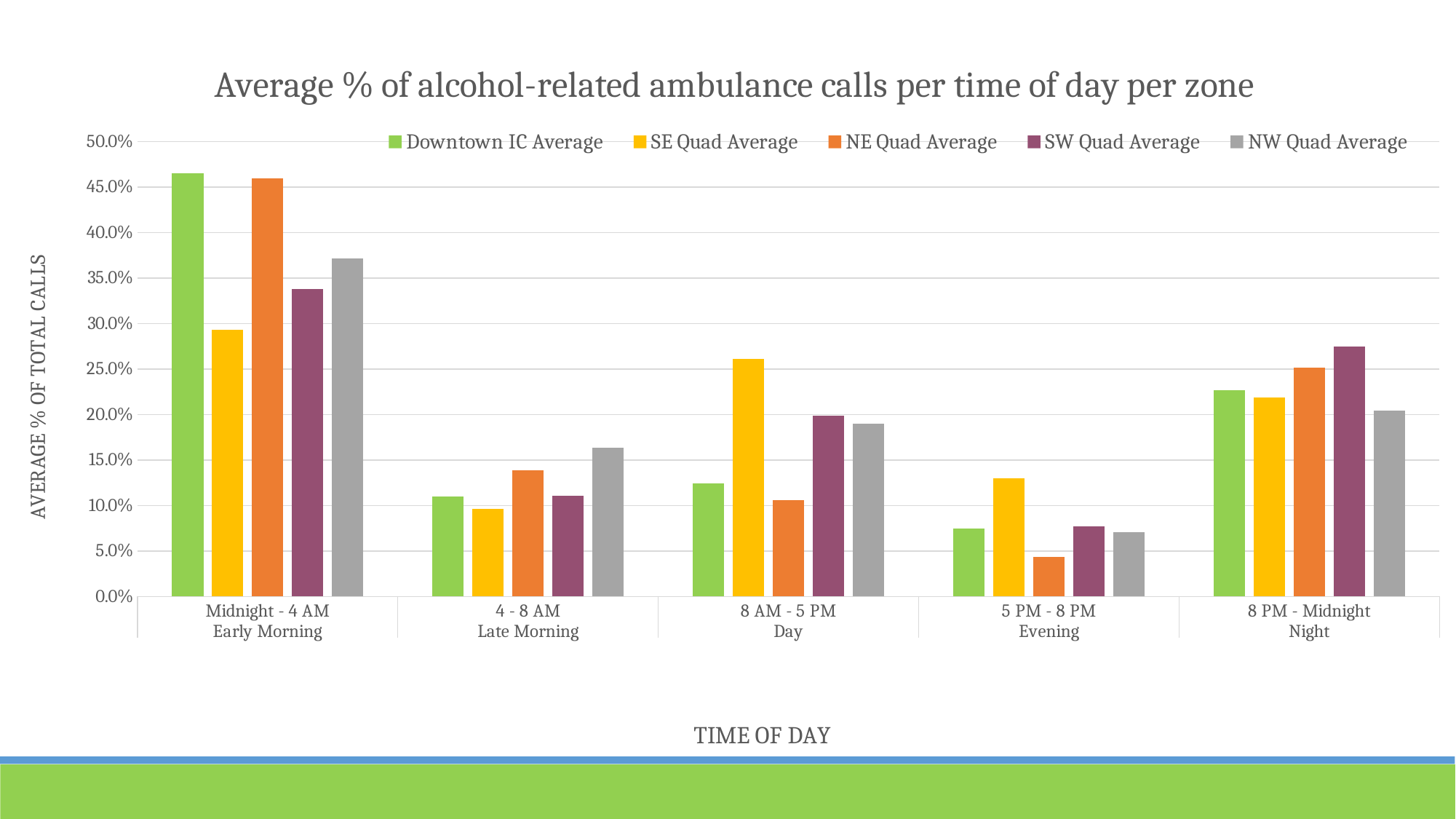
How many time-of-day categories are shown on the x axis? 5 Which series has the highest value for 8 AM - 5 PM Day? SE Quad Average Is the NE Quad Average value for 5 PM - 8 PM Evening greater or less than 5.0%? less Which time of day has the highest Downtown IC Average value? Midnight - 4 AM Early Morning Is the SE Quad Average value for 8 AM - 5 PM Day greater or less than 25.0%? greater How many series does the legend list? 5 Which series has the lowest value for 5 PM - 8 PM Evening? NE Quad Average For 8 PM - Midnight Night, which is larger: SW Quad Average or NW Quad Average? SW Quad Average What is the title of the vertical axis? AVERAGE % OF TOTAL CALLS What kind of chart is shown on the slide? bar chart Is the NW Quad Average value for Midnight - 4 AM Early Morning greater or less than 35.0%? greater For 4 - 8 AM Late Morning, which is larger: NW Quad Average or NE Quad Average? NW Quad Average